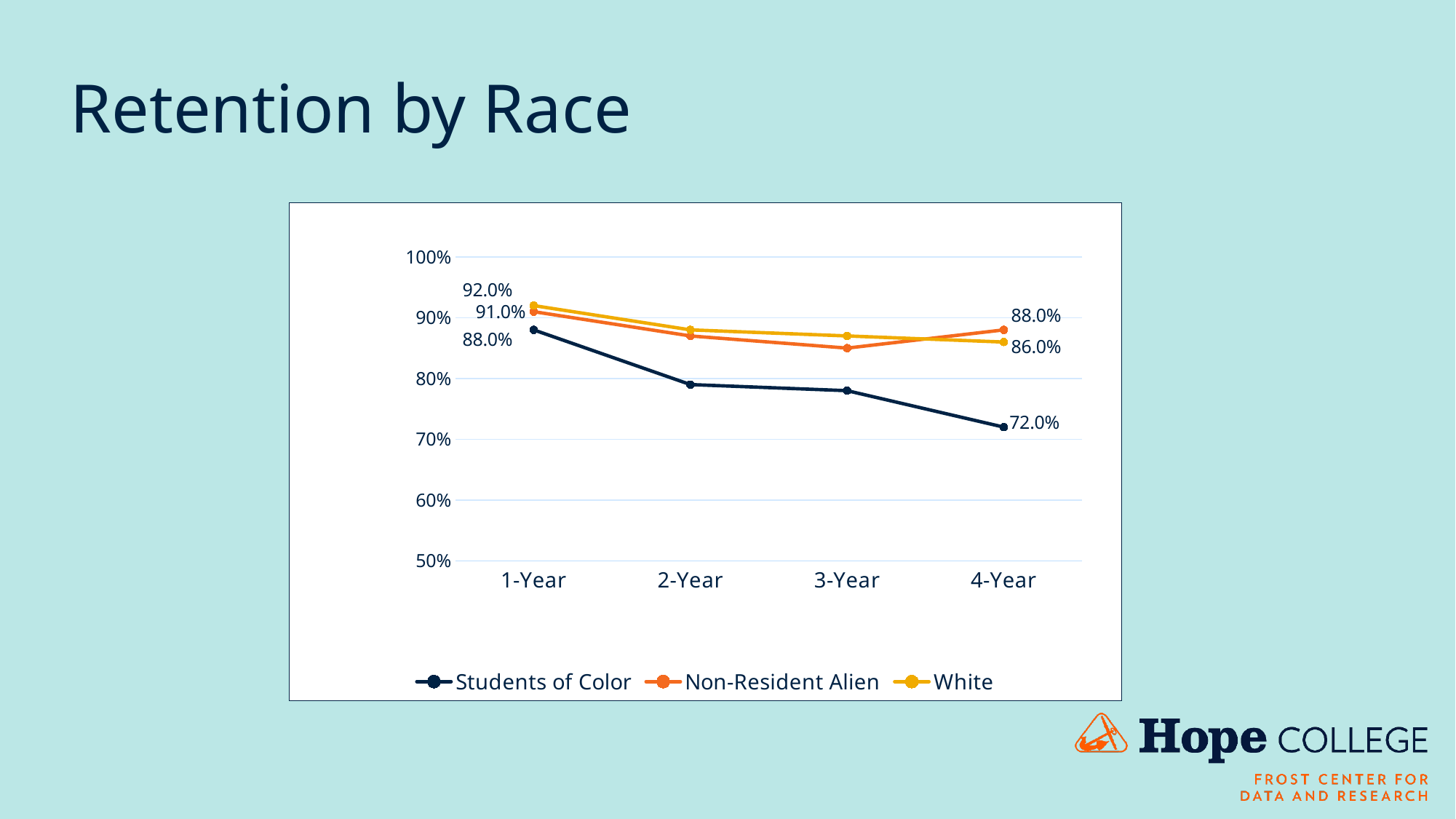
By how many percentage points does the Students of Color retention drop from 1-Year to 4-Year? 16.0 percentage points At 4-Year, which series has the higher value: Non-Resident Alien or White? Non-Resident Alien What is the 1-Year retention value for White students? 92.0% What is the 4-Year retention value for Students of Color? 72.0% Which series has the lowest value at 4-Year? Students of Color What is the 4-Year retention value for Non-Resident Alien students? 88.0% How many points are there along the x axis? 4 Does the Students of Color line rise or fall from 1-Year to 4-Year? Fall How many series does the legend list? 3 What kind of chart is shown on the slide? Line chart What is the 1-Year retention value for Students of Color? 88.0%